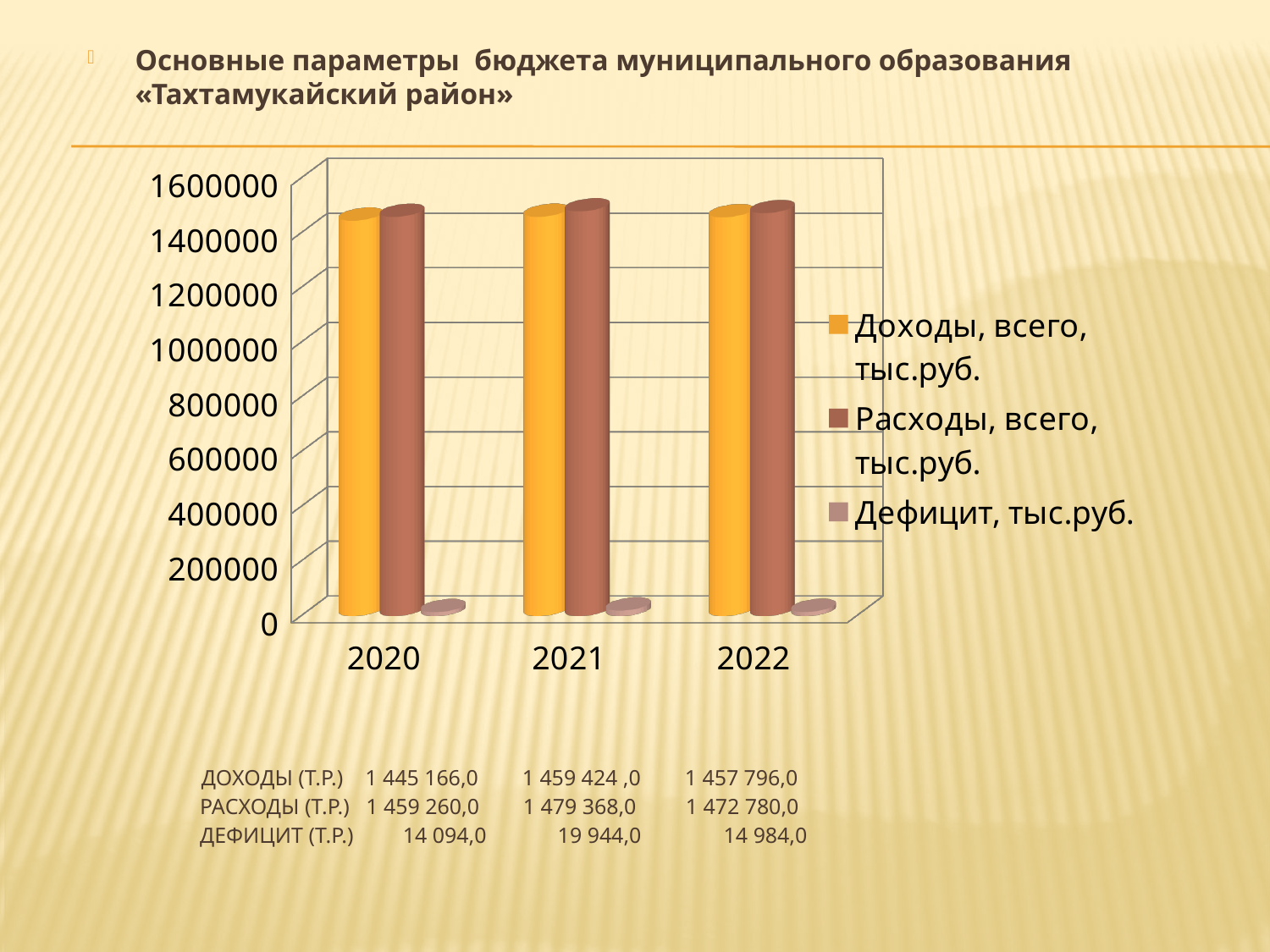
What is the value of Расходы (т.р.) for 2021? 1 479 368,0 Which colour represents the series 'Доходы, всего, тыс.руб.' in the legend? orange In which year is Дефицит the highest? 2021 What kind of chart is shown on the slide? bar chart Is the value for Доходы in 2021 greater or less than 1400000? greater How many series does the legend list? 3 What is the difference between Расходы and Доходы in 2020? 14 094,0 Which is larger in 2022, Доходы or Расходы? Расходы What is the value of Дефицит (т.р.) for 2022? 14 984,0 In which year is Расходы the highest? 2021 How many years are shown on the x axis of the chart? 3 What is the value of Доходы (т.р.) for 2020? 1 445 166,0